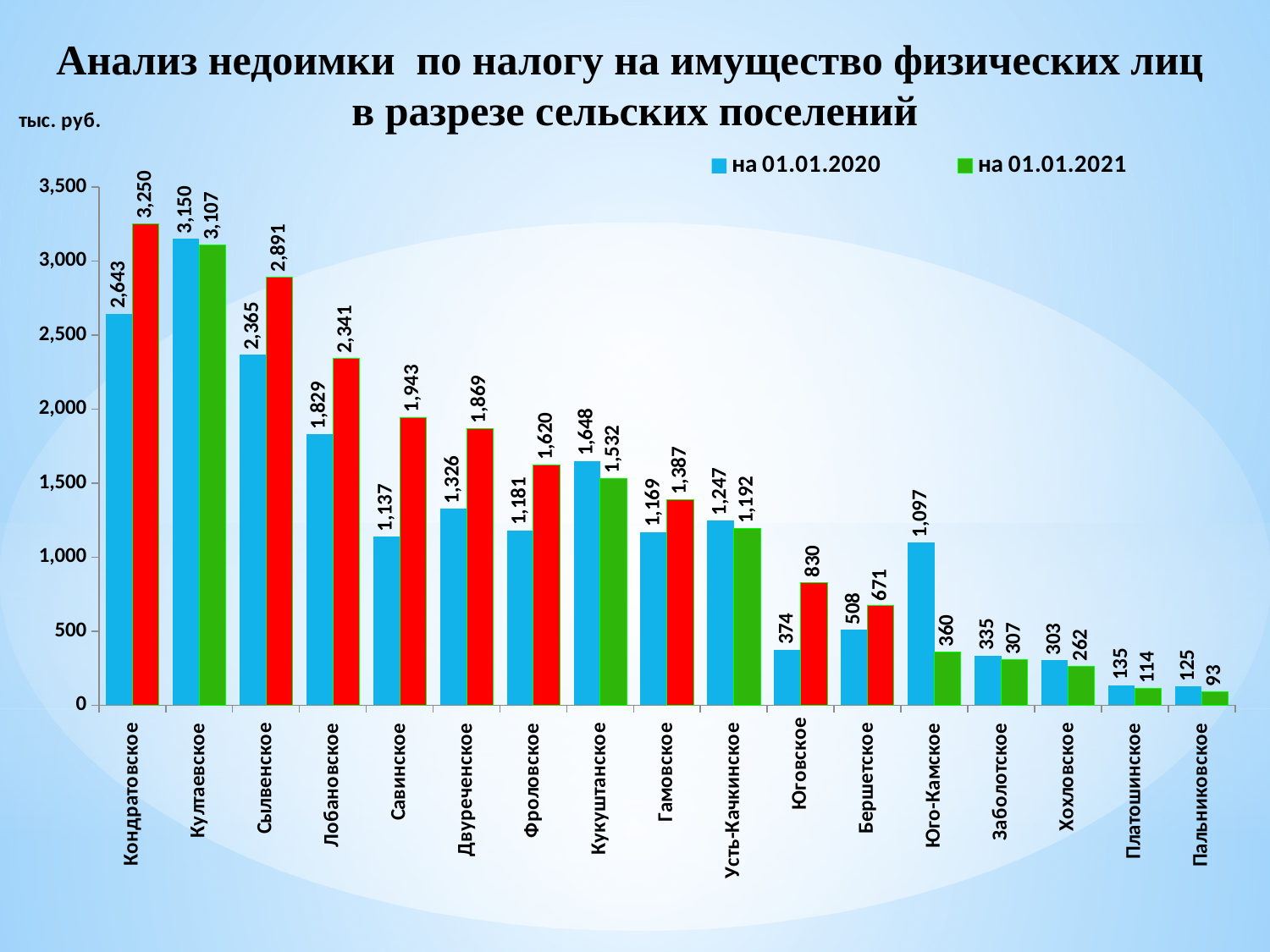
How many settlements are shown on the x axis? 17 What is the value for Кондратовское in the series на 01.01.2021? 3,250 Which settlement has the lowest value in the series на 01.01.2021? Пальниковское What kind of chart is shown on the slide? Bar chart What is the value for Савинское in the series на 01.01.2020? 1,137 For Кукуштанское, which is larger: the value на 01.01.2020 or на 01.01.2021? на 01.01.2020 What is the value for Юго-Камское in the series на 01.01.2021? 360 What is the difference between the на 01.01.2021 and на 01.01.2020 values for Кондратовское? 607 What unit is indicated for the values on the chart? тыс. руб. Which settlement has the highest value in the series на 01.01.2020? Култаевское What is the difference between the на 01.01.2020 and на 01.01.2021 values for Юго-Камское? 737 How many series does the legend list? 2